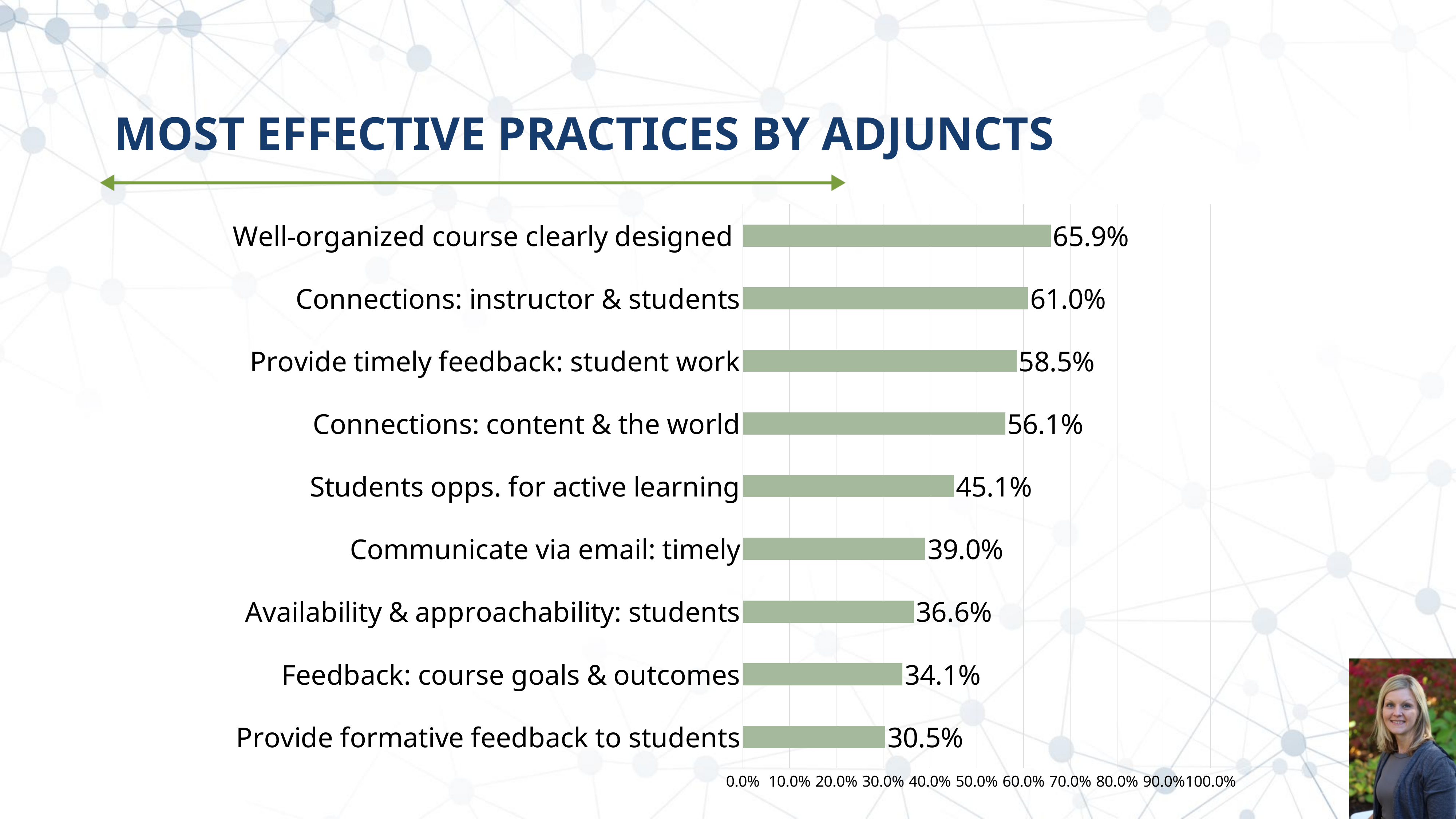
What is the value for "Provide formative feedback to students"? 30.5% What is the difference between "Students opps. for active learning" and "Feedback: course goals & outcomes"? 11.0% What is the value for "Communicate via email: timely"? 39.0% Is the value for "Students opps. for active learning" greater or less than 50.0%? less Which practice has the lowest value? Provide formative feedback to students What is the difference between "Connections: instructor & students" and "Provide timely feedback: student work"? 2.5% How many practices are shown in the chart? 9 What kind of chart is shown on the slide? Bar chart What is the title of the slide? MOST EFFECTIVE PRACTICES BY ADJUNCTS Which practice has the highest value? Well-organized course clearly designed What is the value for "Well-organized course clearly designed"? 65.9% Which is larger: "Connections: content & the world" or "Availability & approachability: students"? Connections: content & the world